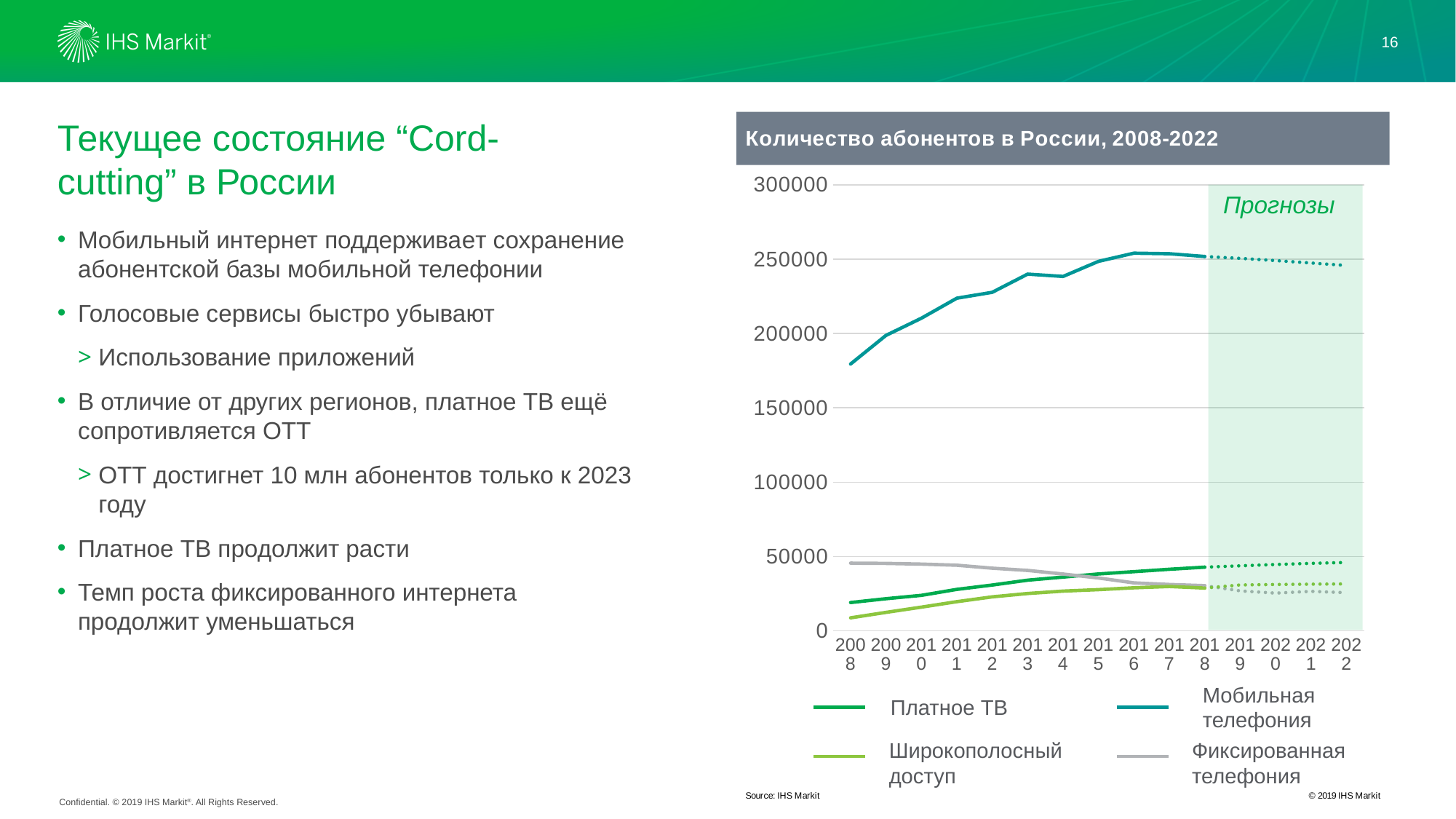
Is the value for Платное ТВ in 2008 greater or less than 50000? less In 2008, which is larger: Фиксированная телефония or Платное ТВ? Фиксированная телефония Which series has the lowest value in 2008? Широкополосный доступ Does the value for Платное ТВ rise or fall from 2008 to 2022? rise How many years are shown along the x axis of the chart? 15 Is the value for Мобильная телефония in 2008 greater or less than 200000? less Which series has the highest values throughout the chart? Мобильная телефония Is the value for Мобильная телефония in 2012 greater or less than 200000? greater How many series does the legend of the chart list? 4 Does the value for Фиксированная телефония rise or fall from 2008 to 2022? fall What is the title of the chart? Количество абонентов в России, 2008-2022 What kind of chart is shown on the slide? line chart